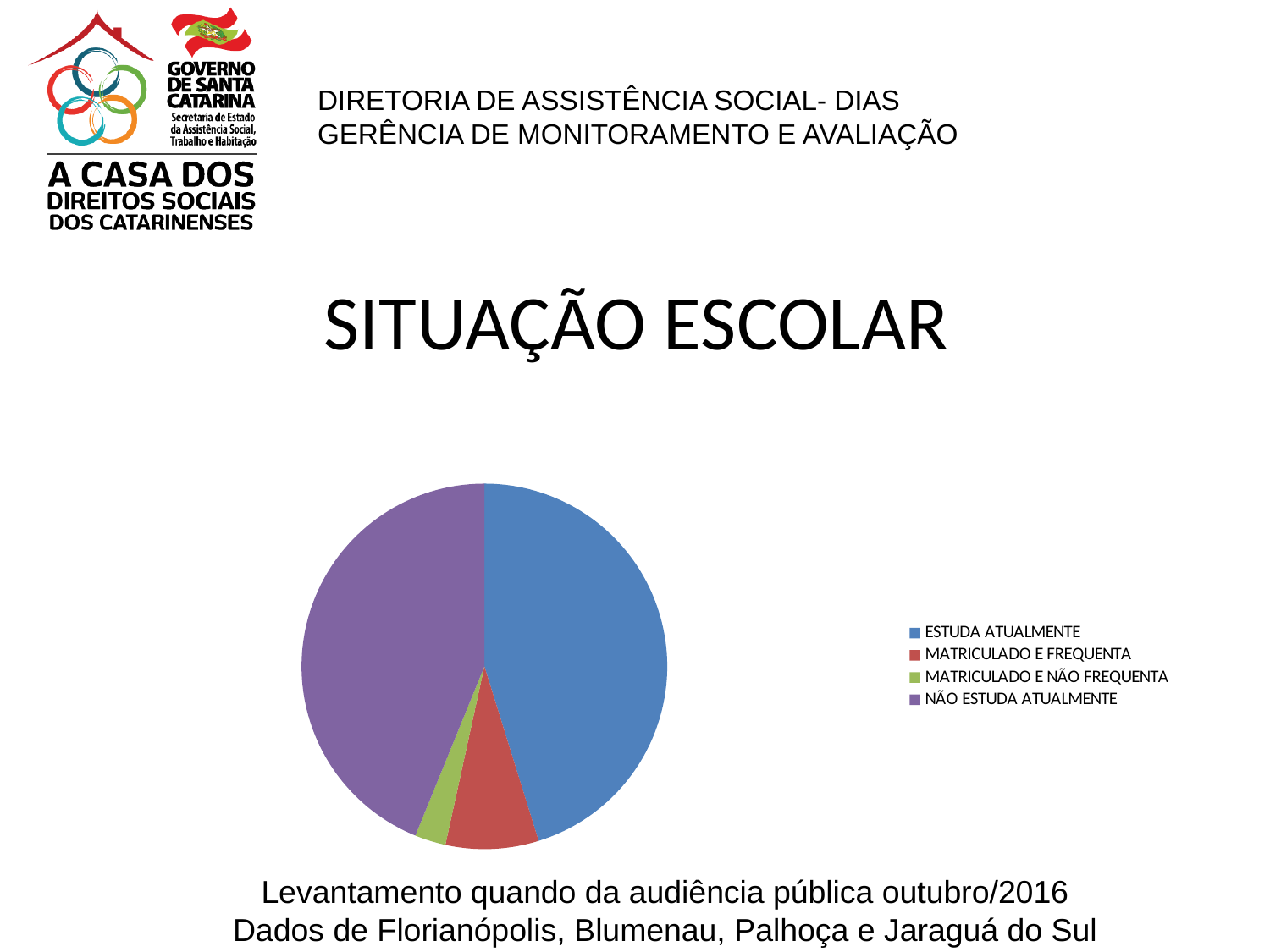
Which slice is larger: MATRICULADO E FREQUENTA or MATRICULADO E NÃO FREQUENTA? MATRICULADO E FREQUENTA What is the title shown above the pie chart? SITUAÇÃO ESCOLAR Which slice is larger: NÃO ESTUDA ATUALMENTE or MATRICULADO E FREQUENTA? NÃO ESTUDA ATUALMENTE Which category has the smallest slice of the pie chart? MATRICULADO E NÃO FREQUENTA How many entries does the legend of the pie chart list? 4 What colour represents NÃO ESTUDA ATUALMENTE in the pie chart? purple What kind of chart is shown on the slide? pie chart How many slices does the pie chart have? 4